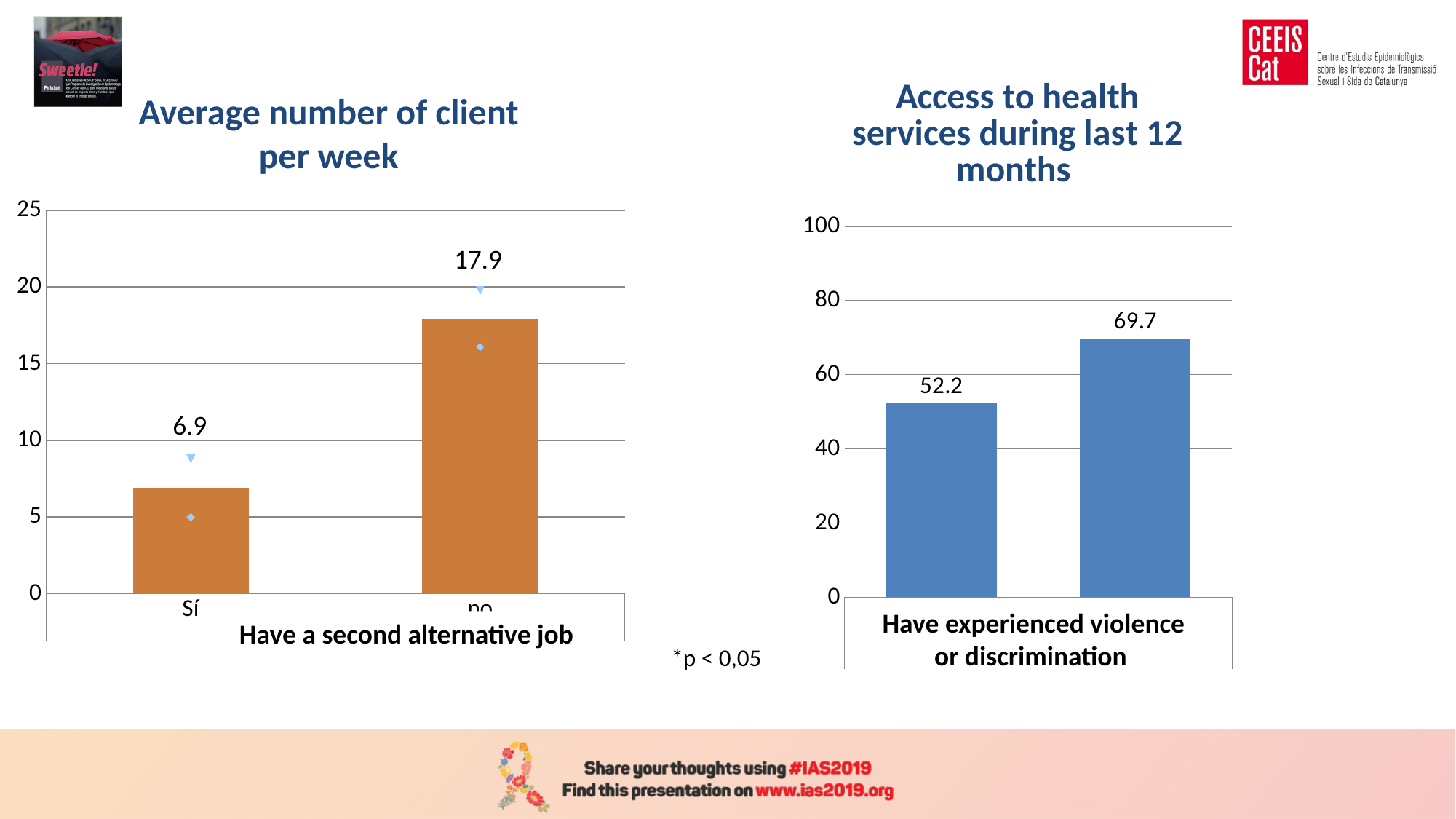
What kind of chart is the 'Average number of client per week' chart? bar chart In the 'Average number of client per week' chart, which category has the higher value? no How many bars are plotted in the 'Average number of client per week' chart? 2 In the 'Access to health services during last 12 months' chart, what is the value of the left bar? 52.2 What is the x-axis title of the 'Access to health services during last 12 months' chart? Have experienced violence or discrimination In the 'Average number of client per week' chart, what is the value for 'Sí'? 6.9 In the 'Access to health services during last 12 months' chart, what is the difference between the right bar and the left bar? 17.5 In the 'Average number of client per week' chart, what is the value for 'no'? 17.9 In the 'Access to health services during last 12 months' chart, what is the value of the right bar? 69.7 In the 'Average number of client per week' chart, is the value for 'no' greater or less than 15? greater In the 'Average number of client per week' chart, what is the difference between the values for 'no' and 'Sí'? 11 What is the x-axis title of the 'Average number of client per week' chart? Have a second alternative job